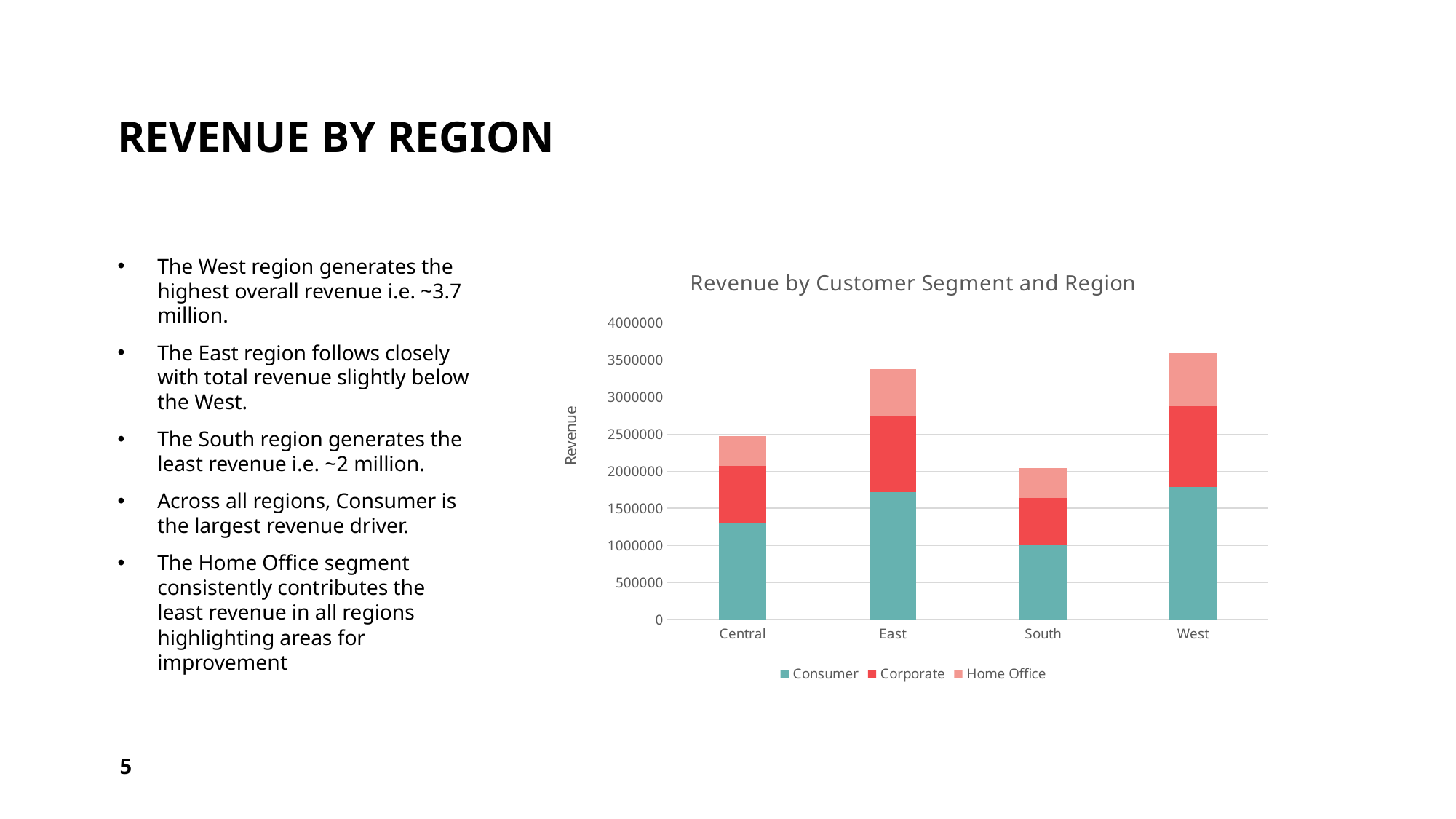
Which region has a larger total revenue bar, East or Central? East How many series does the chart's legend list? 3 Which region has the highest total revenue bar? West Is the total revenue bar for West greater or less than 4000000? less What kind of chart is shown on the slide? Stacked bar chart Which region has the lowest total revenue bar? South Is the total revenue bar for South greater or less than 2500000? less What is the title of the chart? Revenue by Customer Segment and Region Is the total revenue bar for East greater or less than 3000000? greater How many regions are shown on the x axis of the chart? 4 Which segment is shown in the teal colour in the chart's legend? Consumer